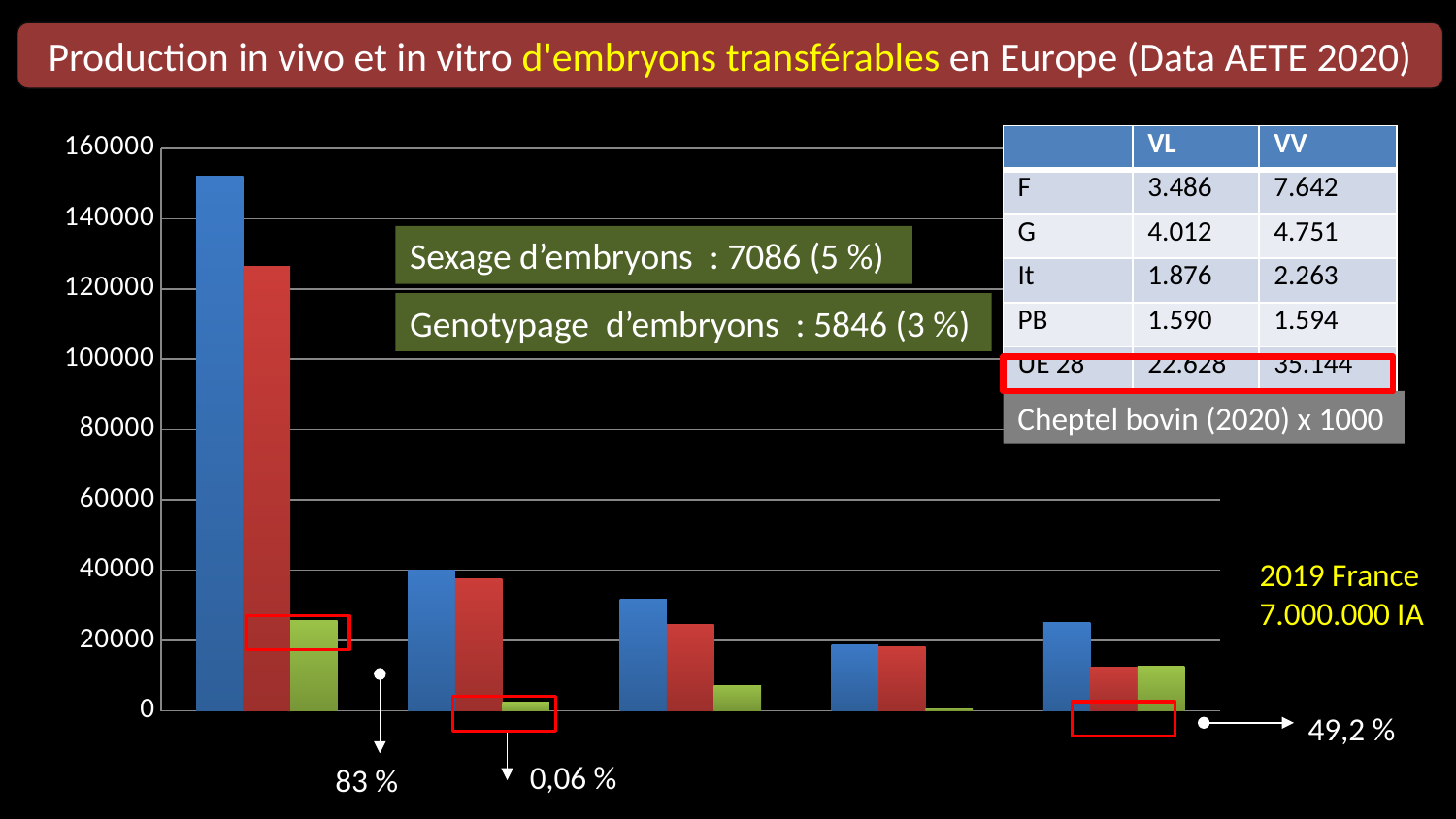
What kind of chart is shown on the slide? bar chart Is the value of the tallest bar (the blue bar in the leftmost group) greater or less than 140000? greater What is the highest tick value shown on the y axis? 160000 How many bars are there in each group? 3 What percentage is annotated below the first group of bars? 83 % How many groups of bars are plotted along the x axis? 5 Is the value of the red bar in the leftmost group greater or less than 120000? greater Is the value of the blue bar in the second group from the left greater or less than 60000? less What percentage is annotated at the far right of the chart, next to the last group? 49,2 % According to the text box on the chart, how many embryos were sexed (Sexage d'embryons)? 7086 (5 %) Which group of bars has the highest values? the leftmost (first) group